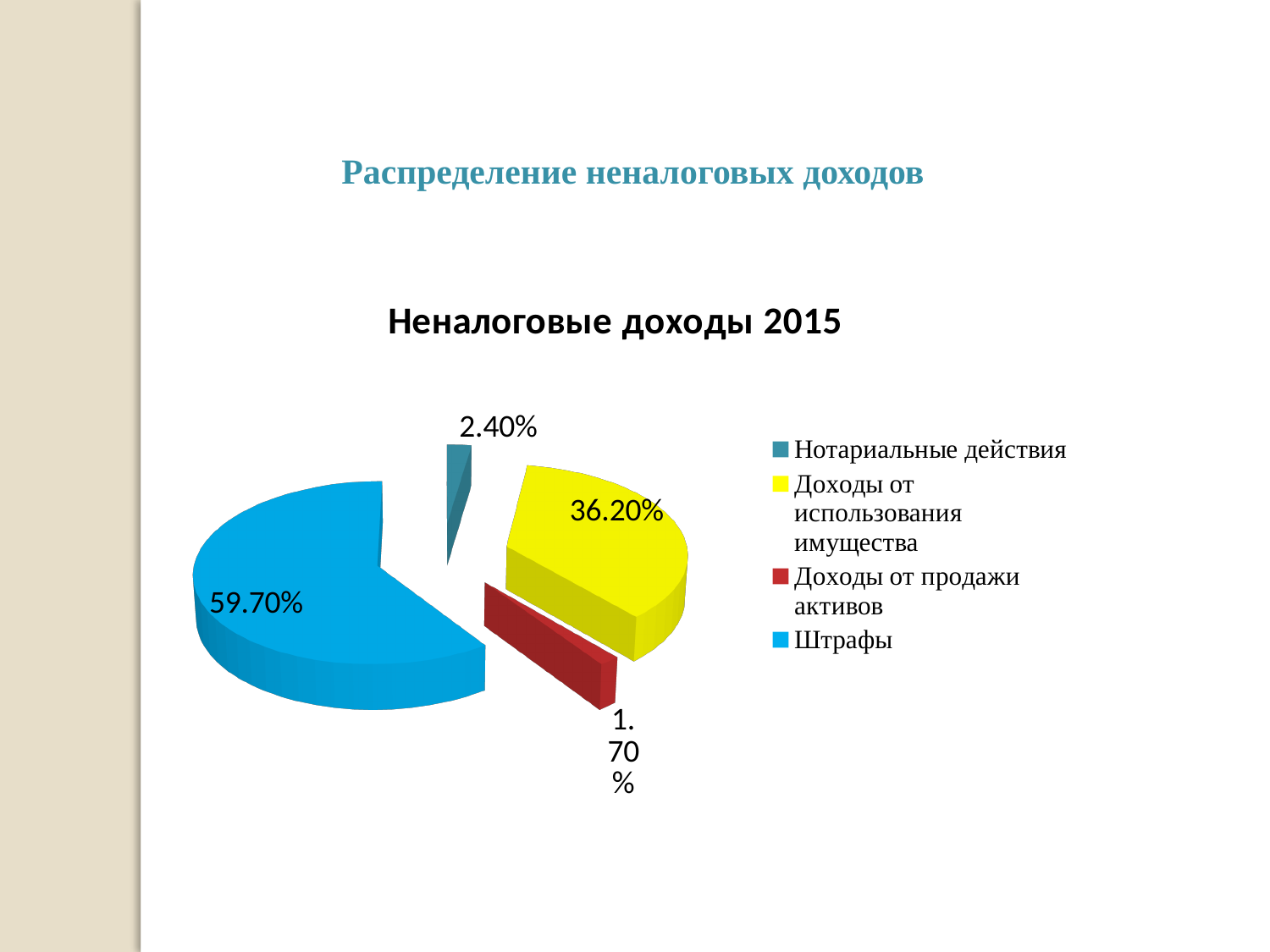
How many categories does the legend list? 4 Which is larger: the share of Нотариальные действия or the share of Доходы от продажи активов? Нотариальные действия What type of chart is shown on the slide? Pie chart What share of the pie is Доходы от использования имущества? 36.20% Which category has the largest share of the pie? Штрафы What is the difference between the shares of Штрафы and Доходы от использования имущества? 23.50% What is the title of the chart? Неналоговые доходы 2015 What share of the pie is Штрафы? 59.70% What share of the pie is Доходы от продажи активов? 1.70% Which category has the smallest share of the pie? Доходы от продажи активов What share of the pie is Нотариальные действия? 2.40% What colour is the slice for Доходы от использования имущества? Yellow